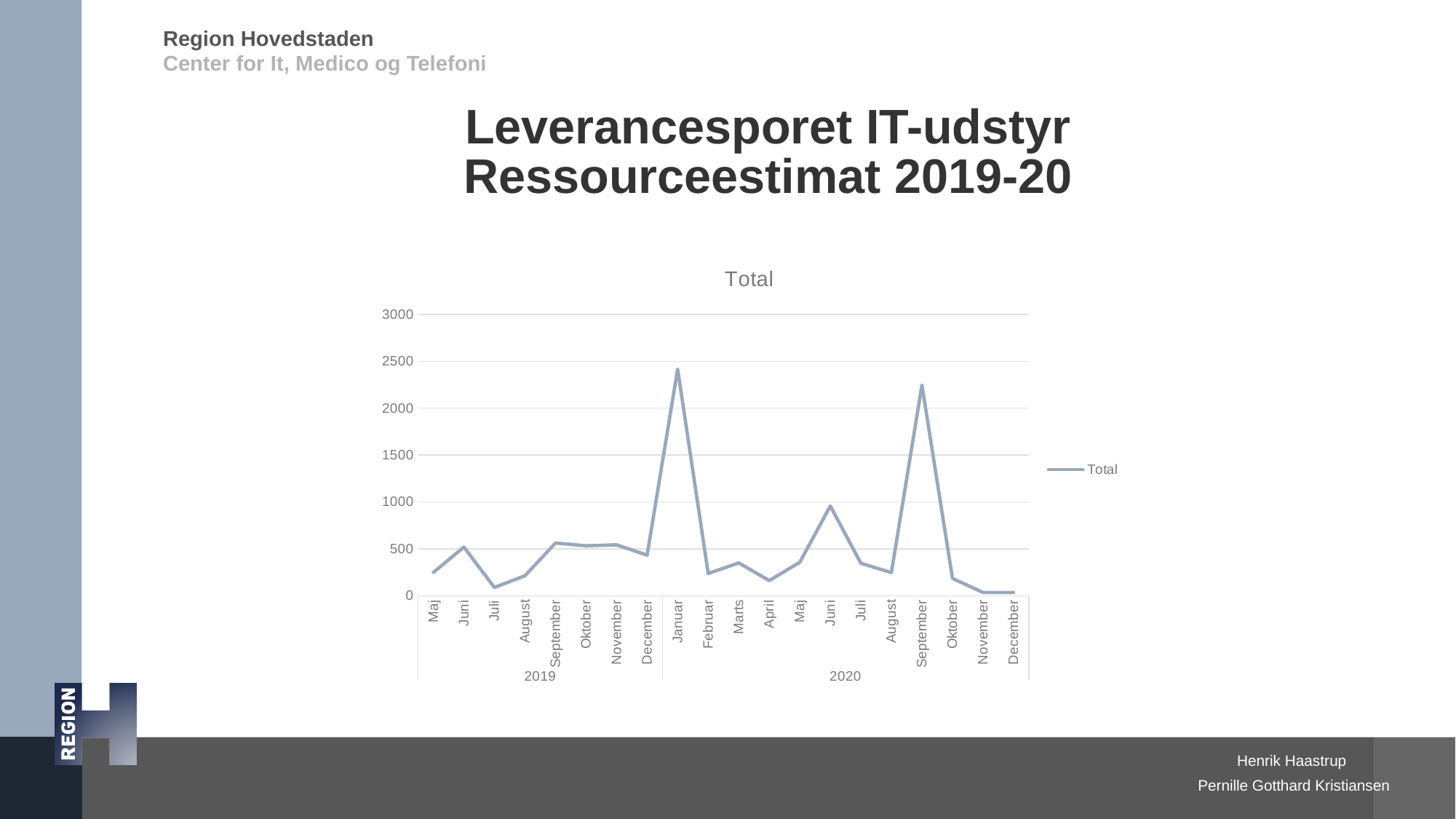
How many monthly data points are plotted on the chart? 20 Which month has the highest value on the chart? Januar 2020 Which is larger, the value for Juni 2019 or the value for Juni 2020? Juni 2020 Do the values rise or fall from April 2020 to Juni 2020? rise Is the value for September 2020 greater or less than 2000? greater How many series does the legend list? 1 Is the value for Juli 2019 greater or less than 500? less What is the title of the chart? Total What kind of chart is shown on the slide? line chart Which is larger, the value for Januar 2020 or the value for September 2020? Januar 2020 Is the value for Januar 2020 greater or less than 2000? greater